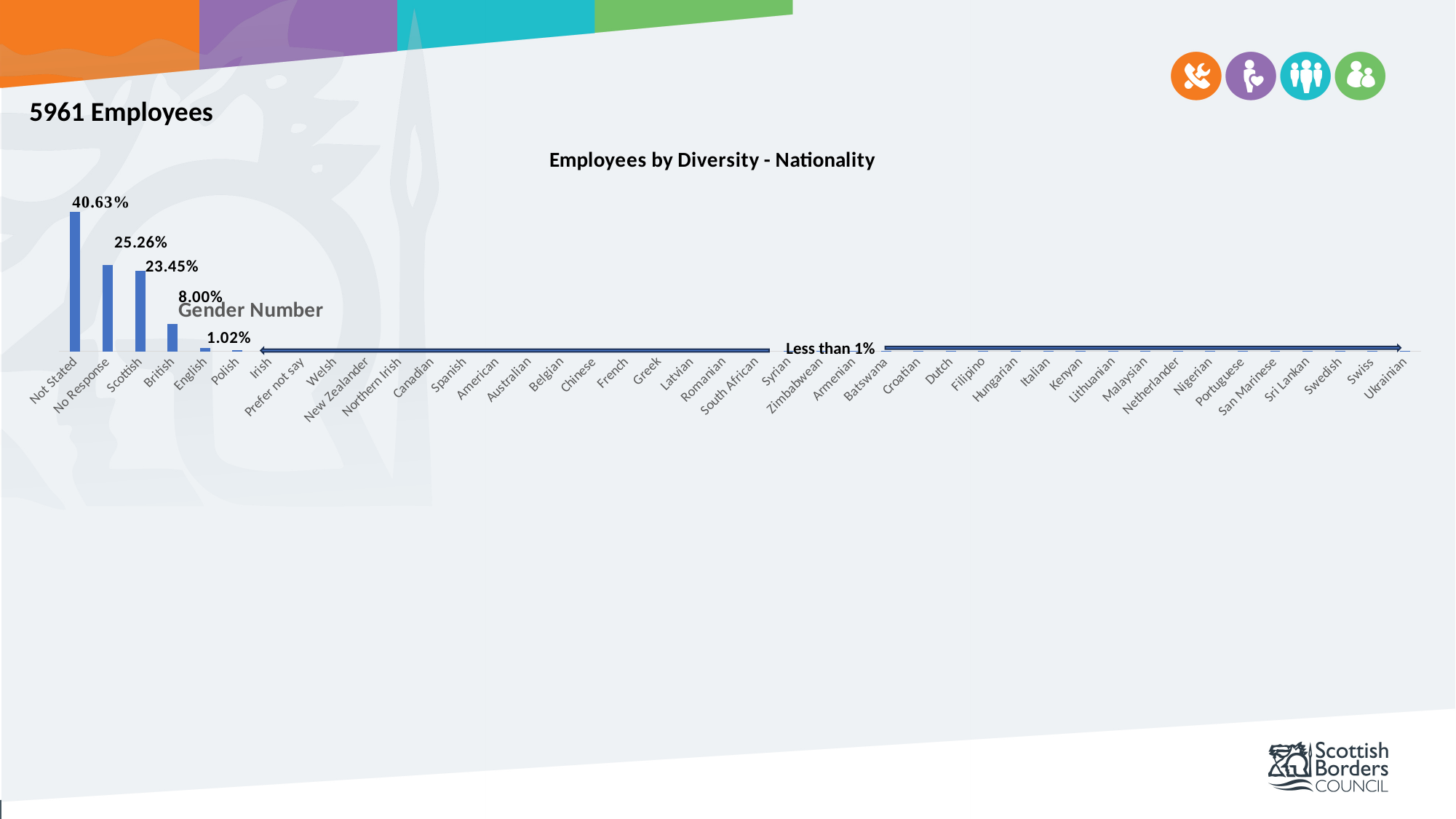
What is the value for Not Stated in the Employees by Diversity - Nationality chart? 40.63% Do the values rise or fall moving from left to right along the x axis? Fall What kind of chart is used to show Employees by Diversity - Nationality? Bar chart What does the annotation above the arrow spanning the categories from Irish to Ukrainian say? Less than 1% What percentage of employees are Scottish according to the chart? 23.45% What is the title of the chart? Employees by Diversity - Nationality Which category has the highest value in the chart? Not Stated Which is larger, the value for No Response or the value for Scottish? No Response What is the value shown for English? 1.02% What is the difference between the values for Not Stated and No Response? 15.37% What is the difference between the values for Scottish and British? 15.45% What is the value shown for British? 8.00%